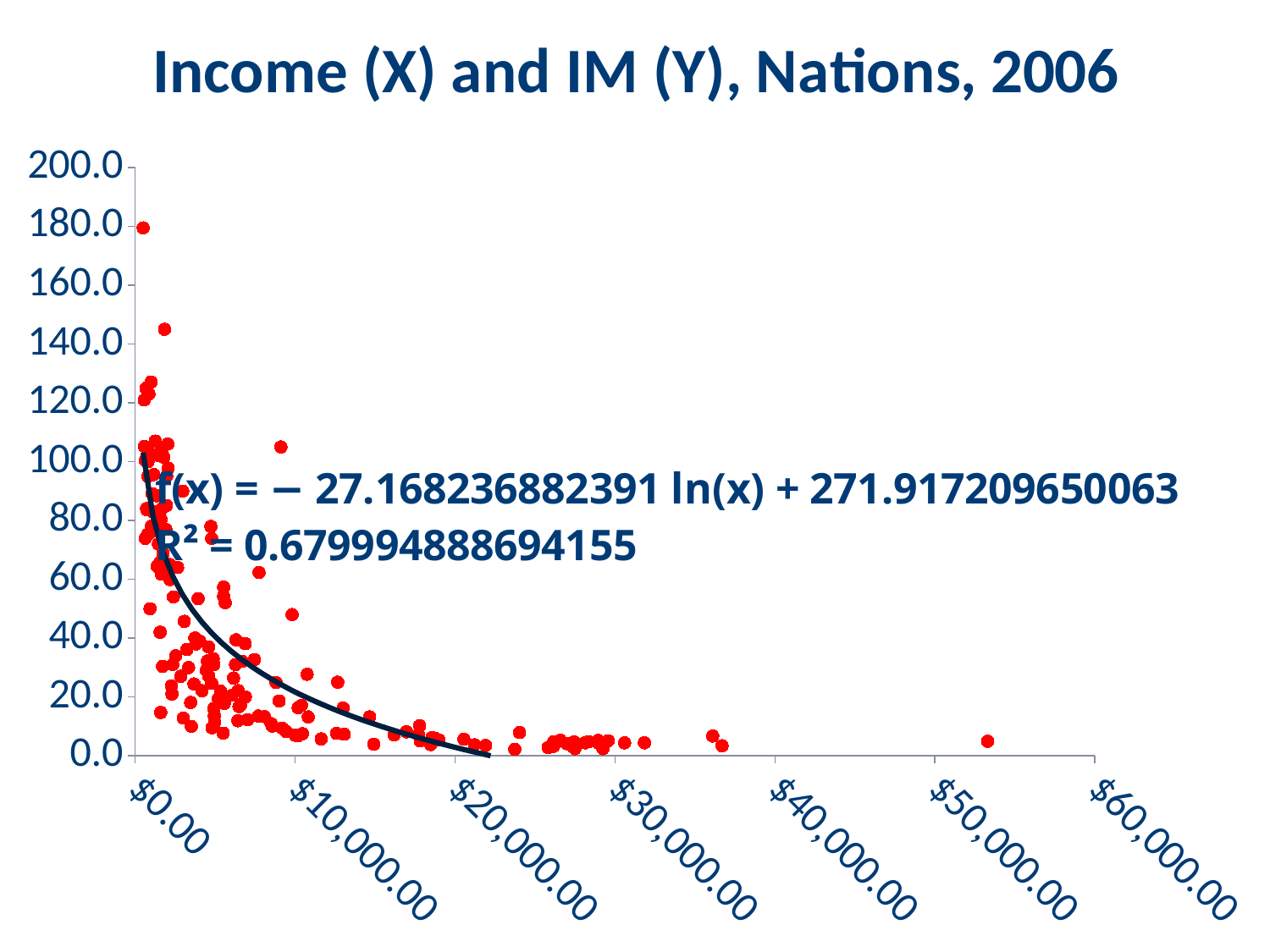
Is the highest IM value plotted on the chart greater or less than 160.0? greater Is the IM value of the point with income near $50,000 greater or less than 20.0? less As income (X) increases along the x axis, do the IM (Y) values generally rise or fall? Fall What R² value is printed on the chart? 0.679994888694155 What is the title of the chart? Income (X) and IM (Y), Nations, 2006 What kind of chart is shown on the slide? Scatter chart What is the highest tick label shown on the x axis? $60,000.00 How many points have an income above $40,000.00? 1 What is the fitted equation f(x) printed on the chart? f(x) = − 27.168236882391 ln(x) + 271.917209650063 What is the highest value shown on the y axis? 200.0 What colour are the data points on the chart? Red What is the coefficient of ln(x) in the fitted equation shown on the chart? − 27.168236882391